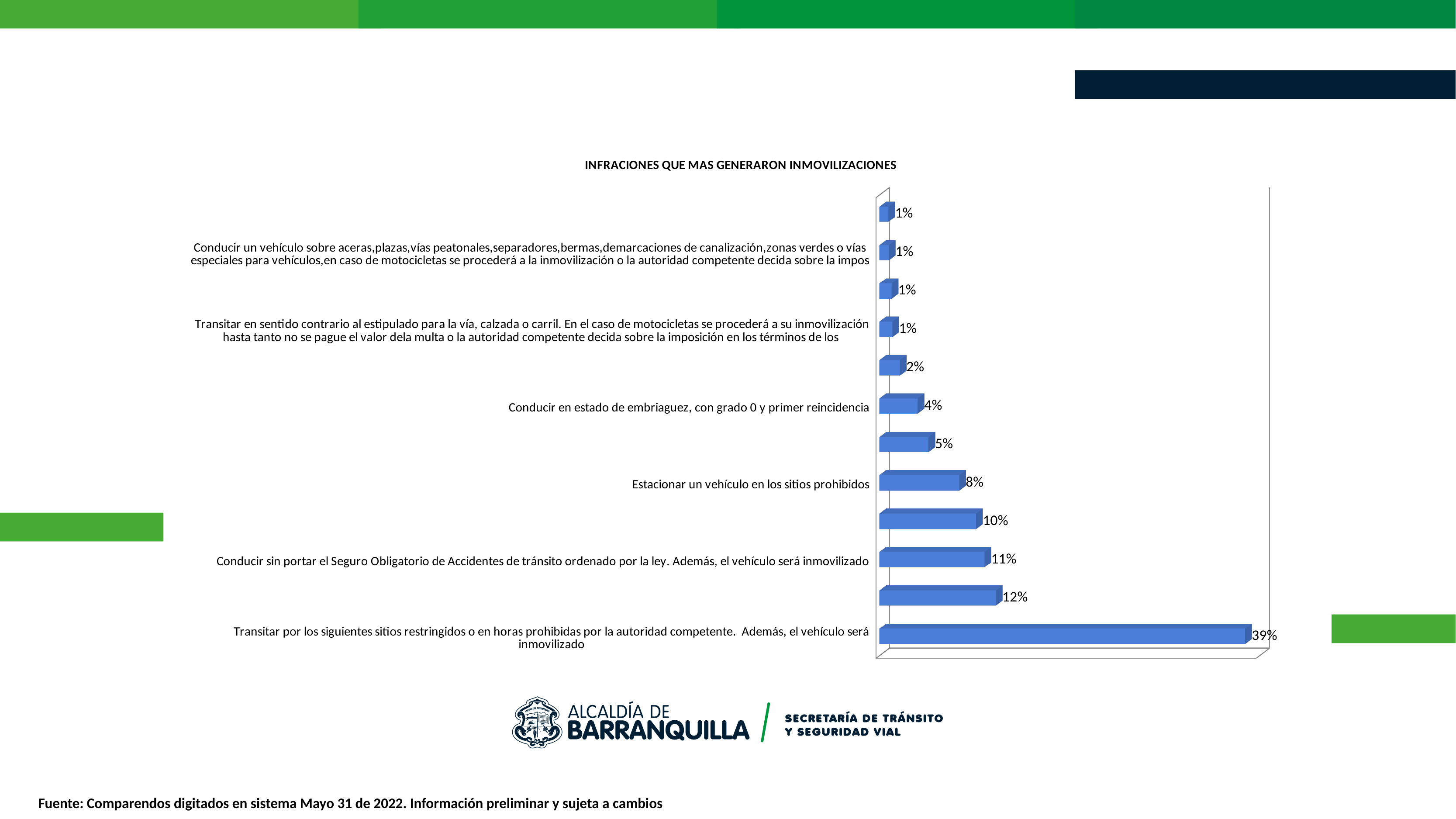
What is the title of the chart? INFRACIONES QUE MAS GENERARON INMOVILIZACIONES What is the value for "Transitar en sentido contrario al estipulado para la vía, calzada o carril..."? 1% Which infraction has the highest value in the chart? Transitar por los siguientes sitios restringidos o en horas prohibidas por la autoridad competente. Además, el vehículo será inmovilizado What is the value for "Conducir en estado de embriaguez, con grado 0 y primer reincidencia"? 4% What is the lowest value shown on any bar in the chart? 1% Which is larger: the value for "Estacionar un vehículo en los sitios prohibidos" or the value for "Conducir en estado de embriaguez, con grado 0 y primer reincidencia"? Estacionar un vehículo en los sitios prohibidos What kind of chart is shown on the slide? Bar chart What is the value for "Transitar por los siguientes sitios restringidos o en horas prohibidas por la autoridad competente. Además, el vehículo será inmovilizado"? 39% What is the value for "Estacionar un vehículo en los sitios prohibidos"? 8% What is the value for "Conducir sin portar el Seguro Obligatorio de Accidentes de tránsito ordenado por la ley. Además, el vehículo será inmovilizado"? 11% How many bars does the chart contain? 12 What is the difference between the value for "Transitar por los siguientes sitios restringidos..." (39%) and "Conducir sin portar el Seguro Obligatorio..." (11%)? 28%